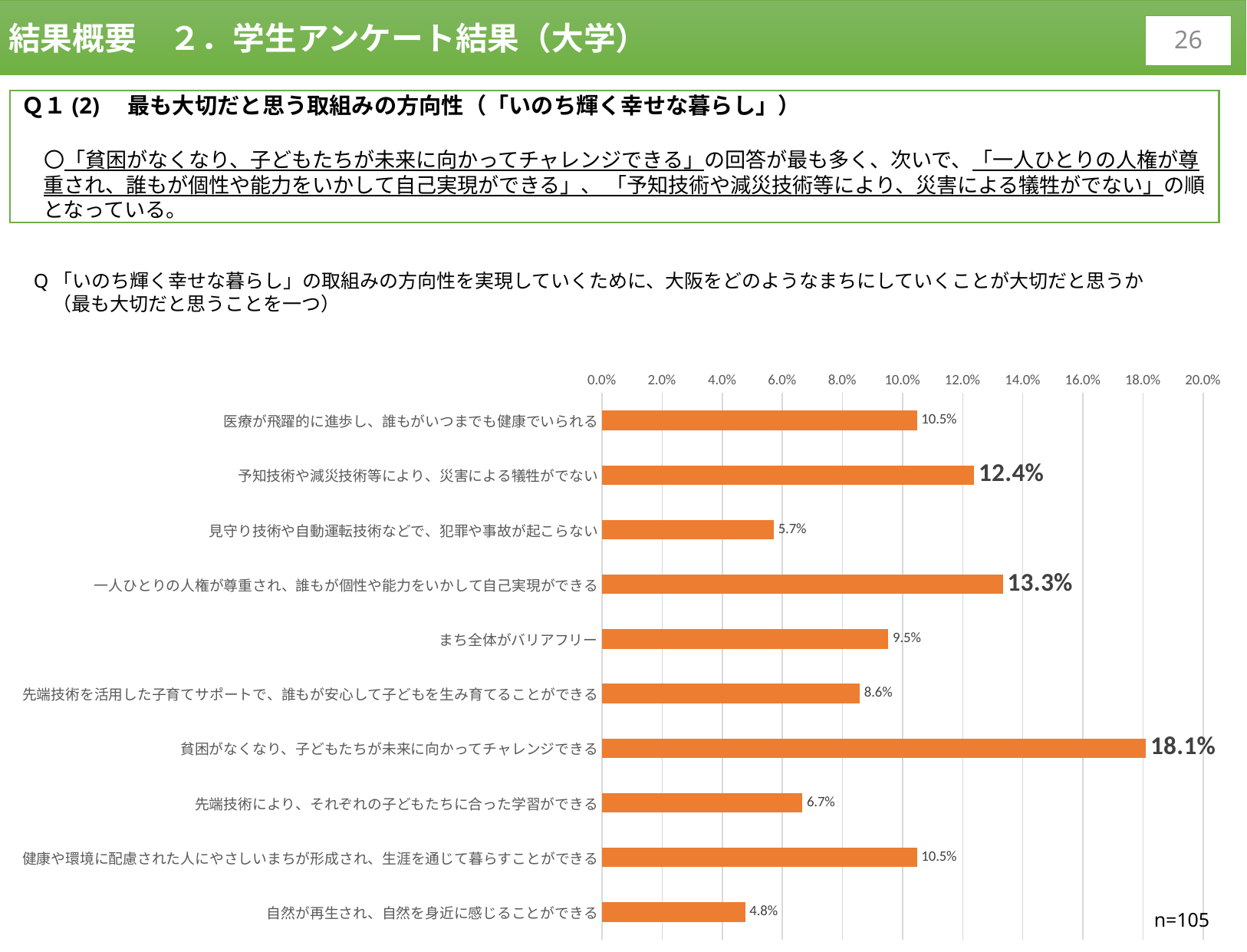
Which category has the lowest value? 自然が再生され、自然を身近に感じることができる What is the difference between 「一人ひとりの人権が尊重され、誰もが個性や能力をいかして自己実現ができる」 and 「予知技術や減災技術等により、災害による犠牲がでない」? 0.9% Which is larger: 「先端技術により、それぞれの子どもたちに合った学習ができる」 or 「先端技術を活用した子育てサポートで、誰もが安心して子どもを生み育てることができる」? 先端技術を活用した子育てサポートで、誰もが安心して子どもを生み育てることができる Is the value for 「医療が飛躍的に進歩し、誰もがいつまでも健康でいられる」 greater or less than 10.0%? greater What kind of chart is shown on the slide? bar chart What is the maximum value shown on the horizontal axis? 20.0% What is the sample size (n) shown on the chart? n=105 What is the value for 「まち全体がバリアフリー」? 9.5% What is the value for 「見守り技術や自動運転技術などで、犯罪や事故が起こらない」? 5.7% Which category has the highest value? 貧困がなくなり、子どもたちが未来に向かってチャレンジできる How many categories are shown in the chart? 10 What is the value for 「貧困がなくなり、子どもたちが未来に向かってチャレンジできる」? 18.1%